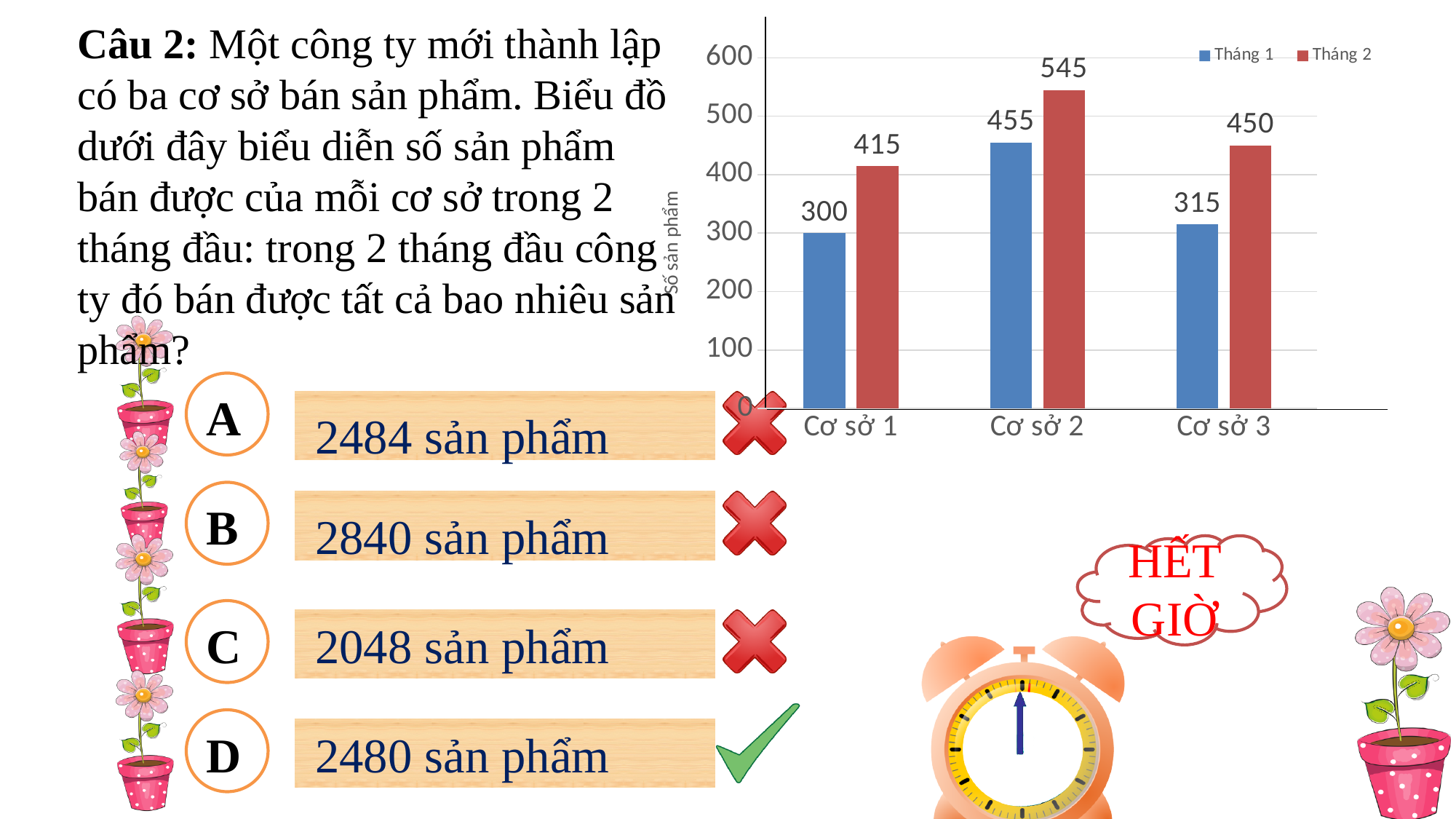
What is the difference between Tháng 2 and Tháng 1 at Cơ sở 3? 135 How many cơ sở categories are shown on the x axis? 3 What is the value for Tháng 2 at Cơ sở 3? 450 How many series does the legend list? 2 What is the value for Tháng 2 at Cơ sở 2? 545 What is the label on the vertical axis of the chart? Số sản phẩm Which is larger at Cơ sở 1: Tháng 1 or Tháng 2? Tháng 2 What is the value for Tháng 1 at Cơ sở 1? 300 Which cơ sở has the highest value for Tháng 1? Cơ sở 2 Which cơ sở has the lowest value for Tháng 2? Cơ sở 1 What is the total of Tháng 1 across all three cơ sở? 1070 What kind of chart is shown on the slide? Bar chart